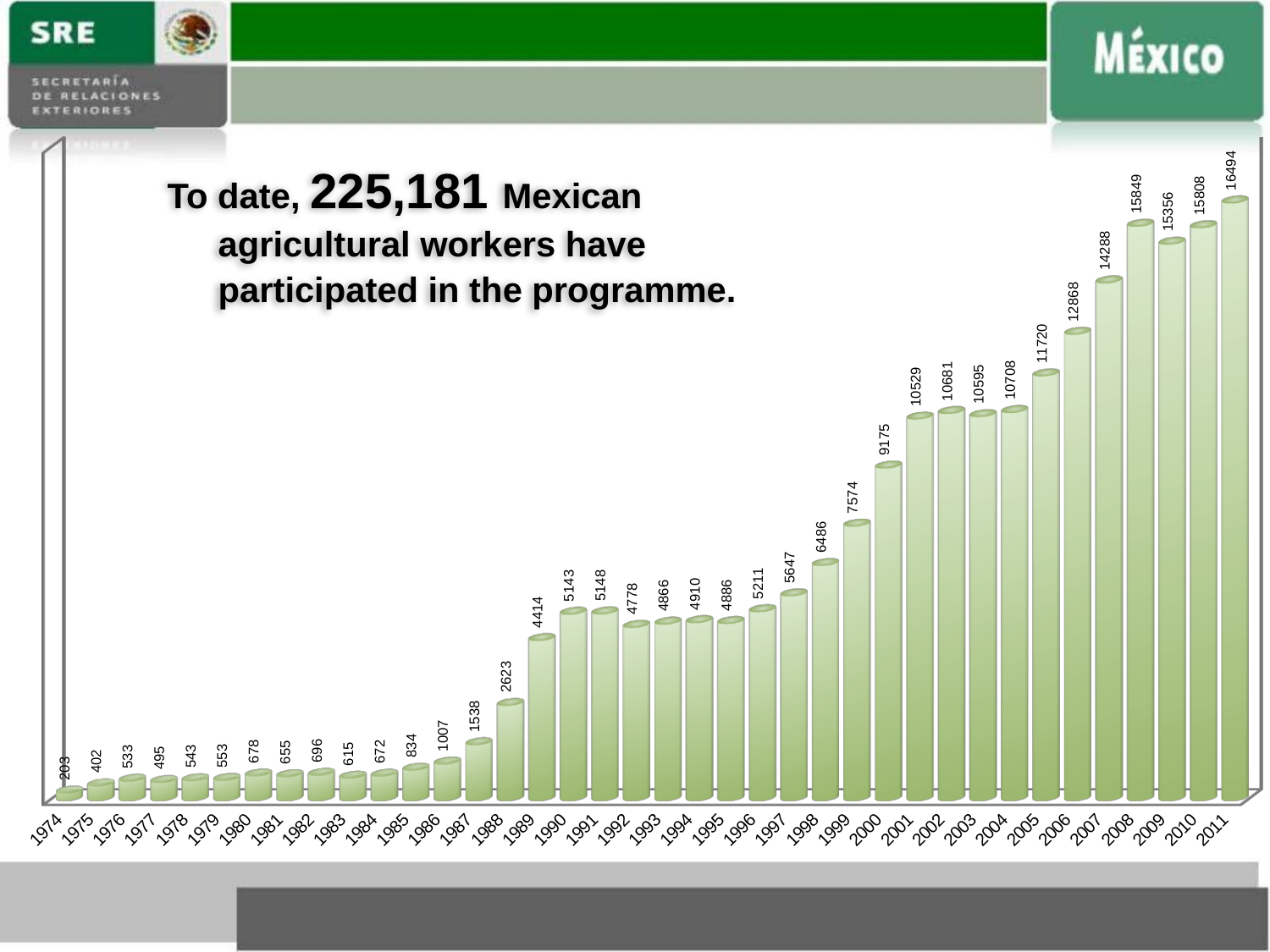
Which is larger, the value for 1999 or the value for 1998? 1999 Do the values generally rise or fall from 1974 to 2011? rise What is the difference between the values for 2011 and 1974? 16291 What is the value shown for 1988? 2623 Which year has the lowest value? 1974 How many years are plotted on the chart? 38 What kind of chart is shown on the slide? bar chart What is the difference between the values for 2008 and 2009? 493 What is the value shown for 2011? 16494 Which year has the highest value? 2011 Which is larger, the value for 2008 or the value for 2010? 2008 What is the value shown for 2000? 9175